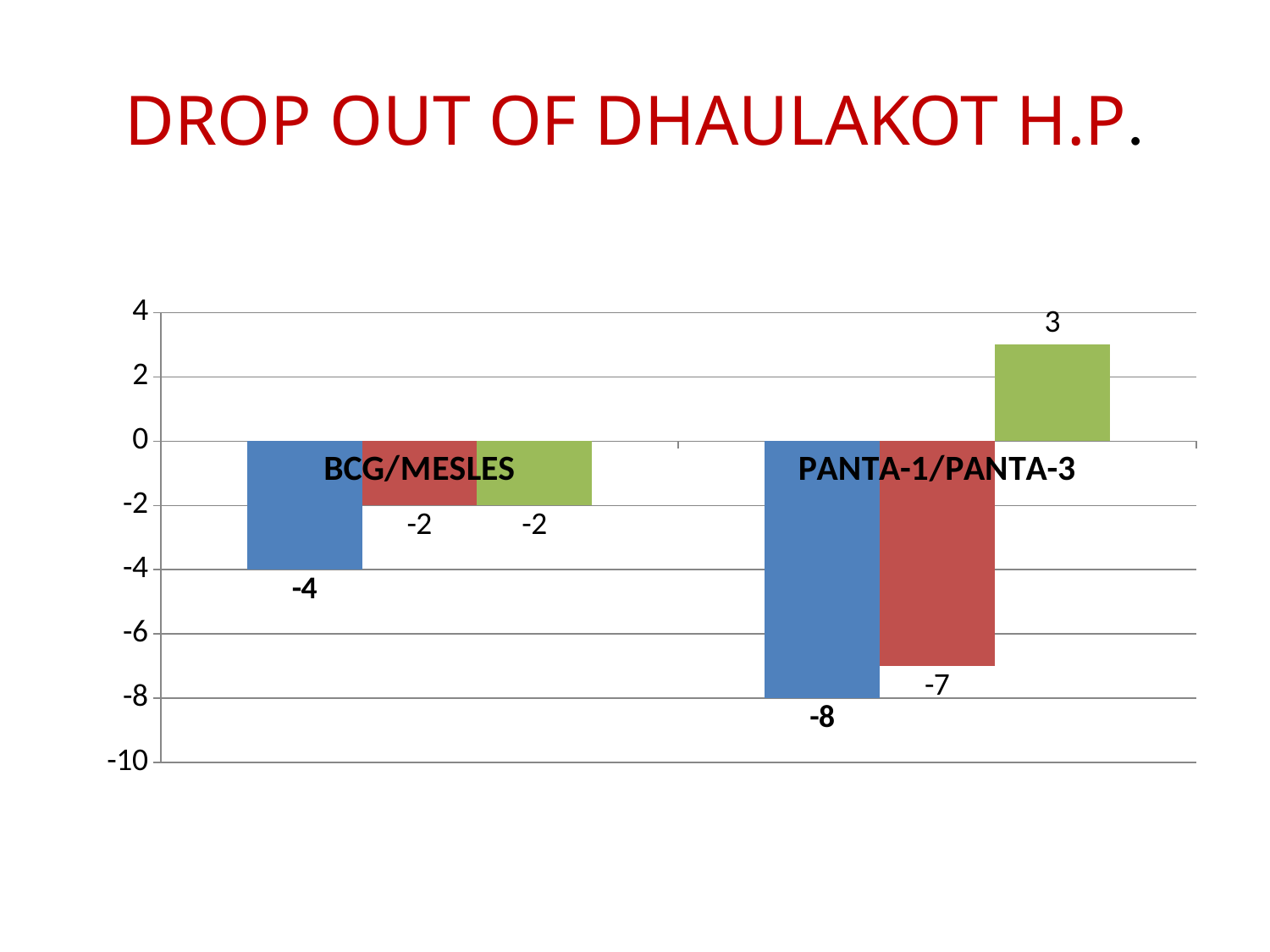
How many categories are shown on the x axis of the chart? 2 Which bar has the lowest value in the chart? the blue bar for PANTA-1/PANTA-3 What is the difference between the blue bar values for PANTA-1/PANTA-3 and BCG/MESLES? 4 What is the title of the slide? DROP OUT OF DHAULAKOT H.P. Which is larger, the green bar for BCG/MESLES or the green bar for PANTA-1/PANTA-3? the green bar for PANTA-1/PANTA-3 What is the value of the green bar for PANTA-1/PANTA-3? 3 What is the value of the blue bar for BCG/MESLES? -4 What kind of chart is shown on the slide? bar chart Which bar has the highest value in the chart? the green bar for PANTA-1/PANTA-3 What is the value of the red bar for BCG/MESLES? -2 What is the value of the red bar for PANTA-1/PANTA-3? -7 What is the value of the blue bar for PANTA-1/PANTA-3? -8